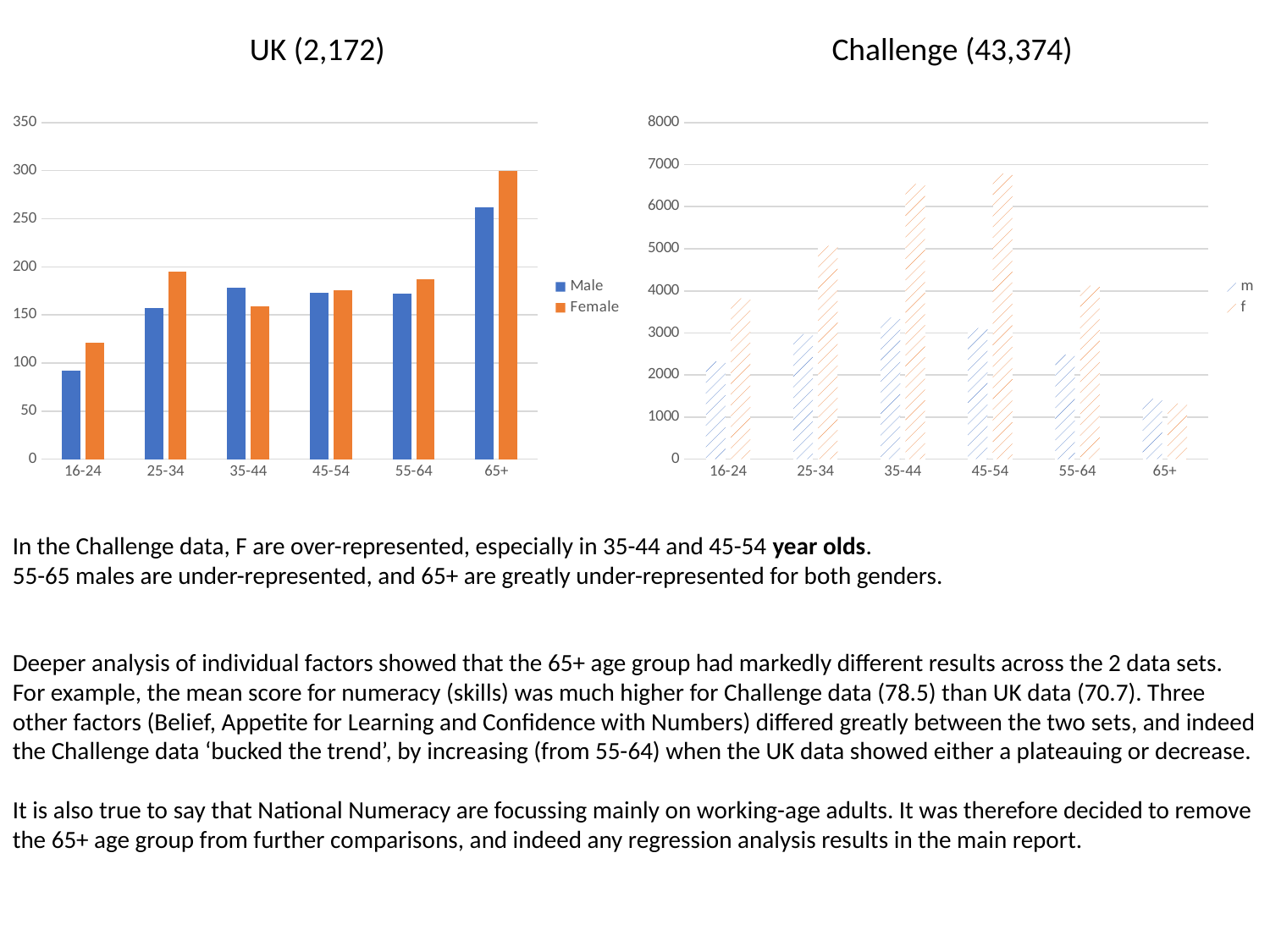
In the Challenge (43,374) chart, is the f value for 35-44 greater or less than 6000? greater In the Challenge (43,374) chart, is the m value for 16-24 greater or less than 3000? less How many series does the legend of the Challenge (43,374) chart list? 2 What are the legend entries of the Challenge (43,374) chart? m and f In the UK (2,172) chart, is the Female value for 65+ greater or less than 250? greater In the Challenge (43,374) chart, which age group has the highest f value? 45-54 How many age groups are shown on the x axis of the UK (2,172) chart? 6 In the UK (2,172) chart, for the 25-34 age group, which is larger, Male or Female? Female How many series does the legend of the UK (2,172) chart list? 2 What kind of chart is the UK (2,172) chart? bar chart In the UK (2,172) chart, which age group has the highest Female value? 65+